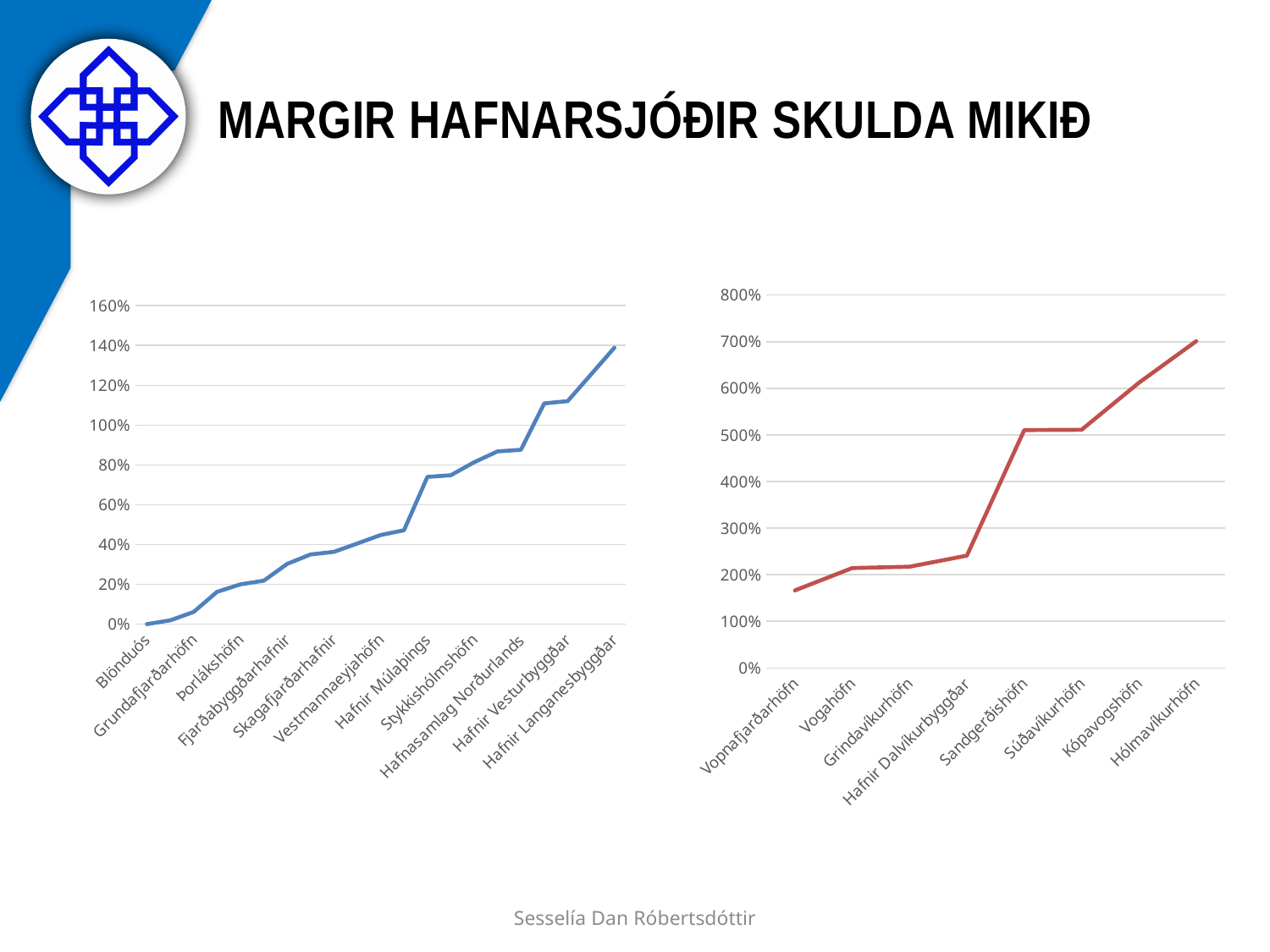
In the chart on the right, is the value for Vopnafjarðarhöfn greater or less than 200%? less In the chart on the left, is the value for Hafnir Vesturbyggðar greater or less than 100%? greater In the chart on the right, is the value for Hólmavíkurhöfn greater or less than 600%? greater How many categories are shown on the x axis of the chart on the right? 8 What kind of chart is the chart on the left of the slide? Line chart In the chart on the right, which category has the lowest value? Vopnafjarðarhöfn In the chart on the right, do the values rise or fall from left to right along the x axis? Rise In the chart on the right, which category has the highest value? Hólmavíkurhöfn In the chart on the left, which category has the highest value? Hafnir Langanesbyggðar In the chart on the left, which category has the lowest value? Blönduós